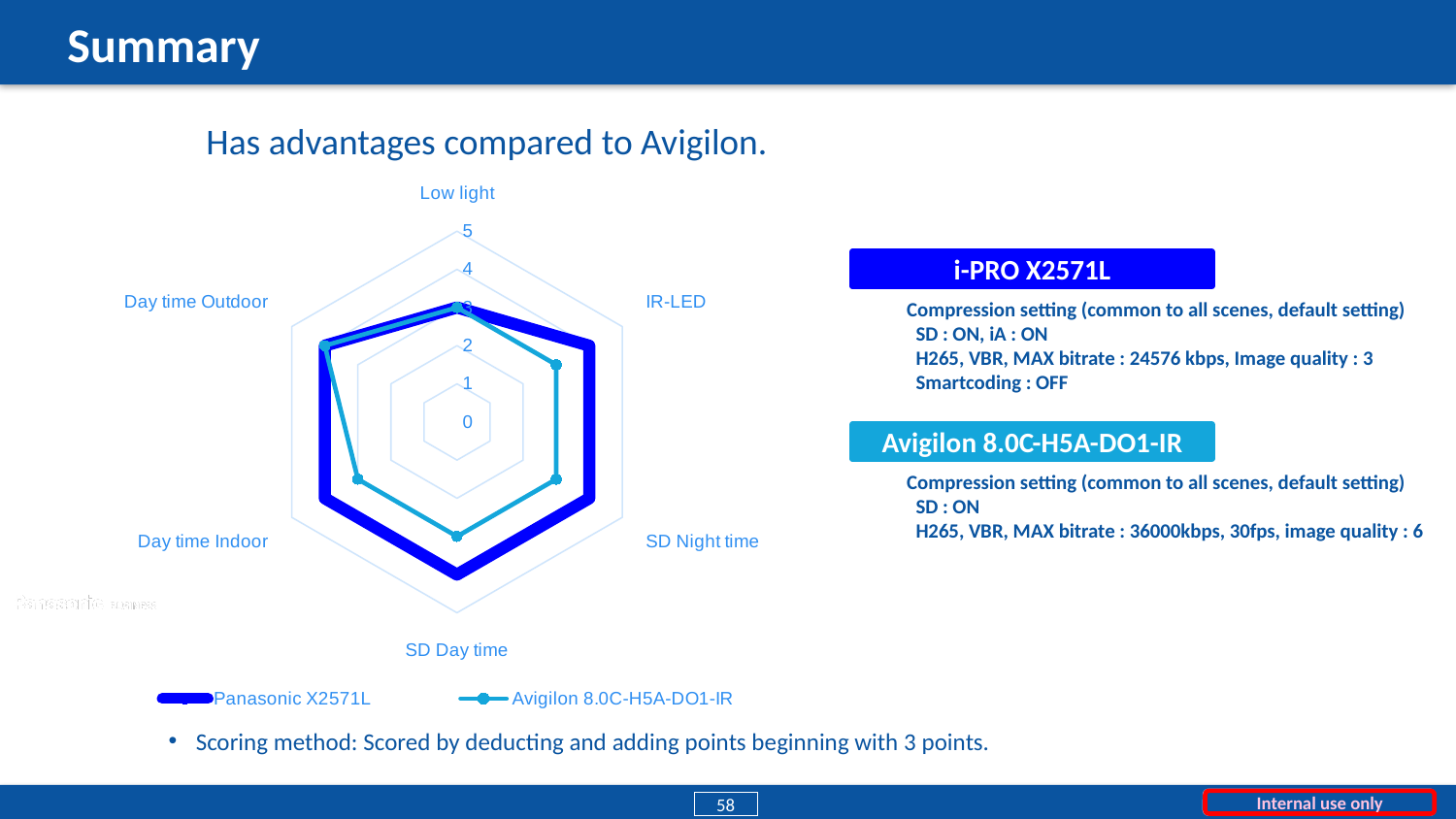
What is the difference between the Panasonic X2571L and Avigilon 8.0C-H5A-DO1-IR values on the Day time Indoor axis? 1 How many series does the chart legend list? 2 Which series is drawn with the thick dark blue line? Panasonic X2571L What is the value for Avigilon 8.0C-H5A-DO1-IR on the SD Night time axis? 3 What is the value for Avigilon 8.0C-H5A-DO1-IR on the Day time Outdoor axis? 4 Which series has the larger value on the SD Day time axis, Panasonic X2571L or Avigilon 8.0C-H5A-DO1-IR? Panasonic X2571L Is the value for Avigilon 8.0C-H5A-DO1-IR on the IR-LED axis greater or less than 4? less How many categories (axes) does the radar chart have? 6 What is the value for Panasonic X2571L on the IR-LED axis? 4 What is the value for Panasonic X2571L on the Low light axis? 3 What is the maximum value shown on the radar chart's scale? 5 What kind of chart is shown on the slide? radar chart